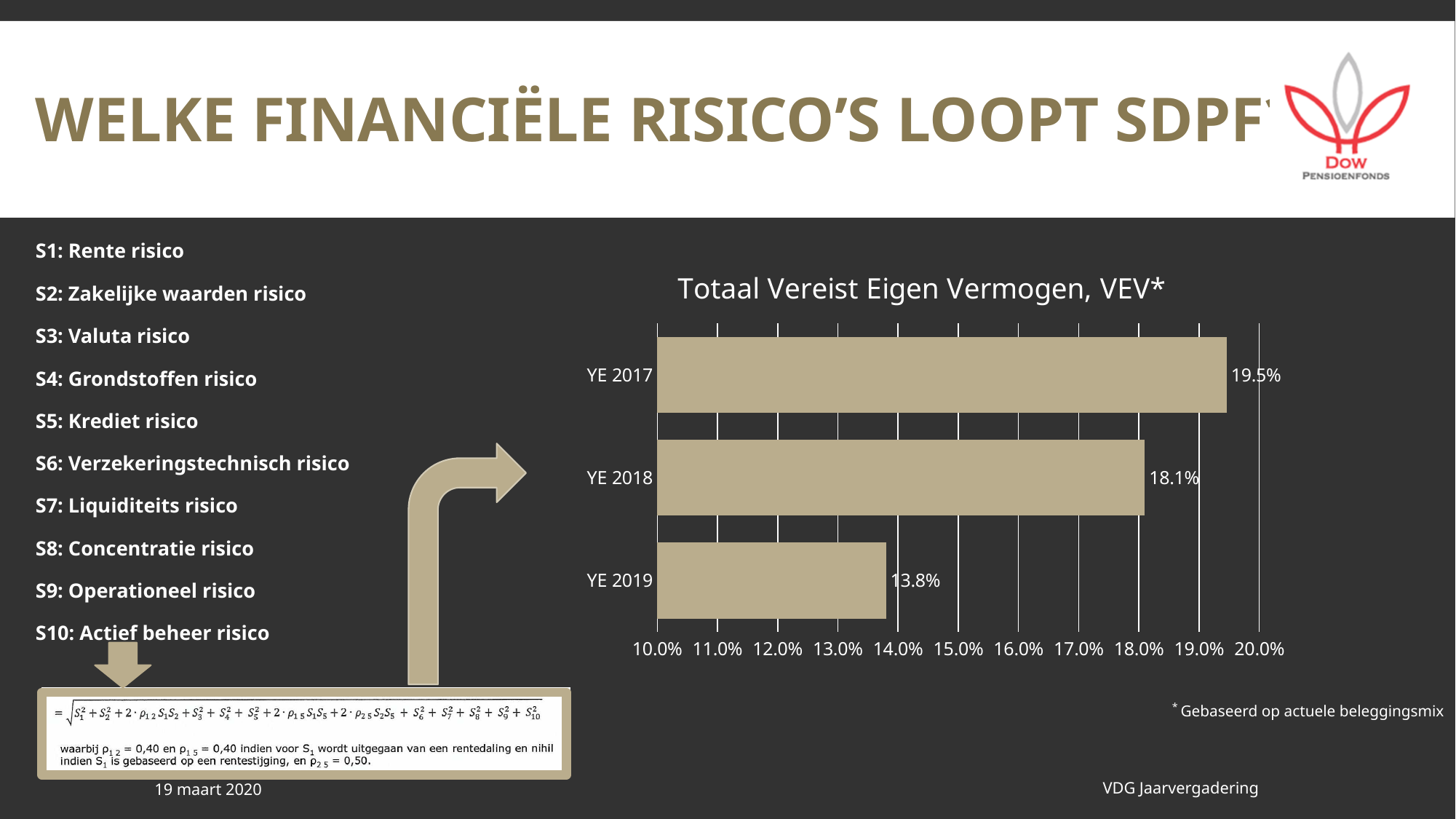
Which year has the lowest value? YE 2019 Which year has the highest value? YE 2017 What is the title of the chart? Totaal Vereist Eigen Vermogen, VEV* What is the difference between the values for YE 2018 and YE 2019? 4.3% Is the value for YE 2019 greater or less than 15.0%? less Which is larger, the value for YE 2018 or YE 2019? YE 2018 What is the value for YE 2018? 18.1% What is the value for YE 2019? 13.8% What kind of chart is shown? bar chart How many categories are shown in the chart? 3 What is the value for YE 2017? 19.5% What is the difference between the values for YE 2017 and YE 2019? 5.7%